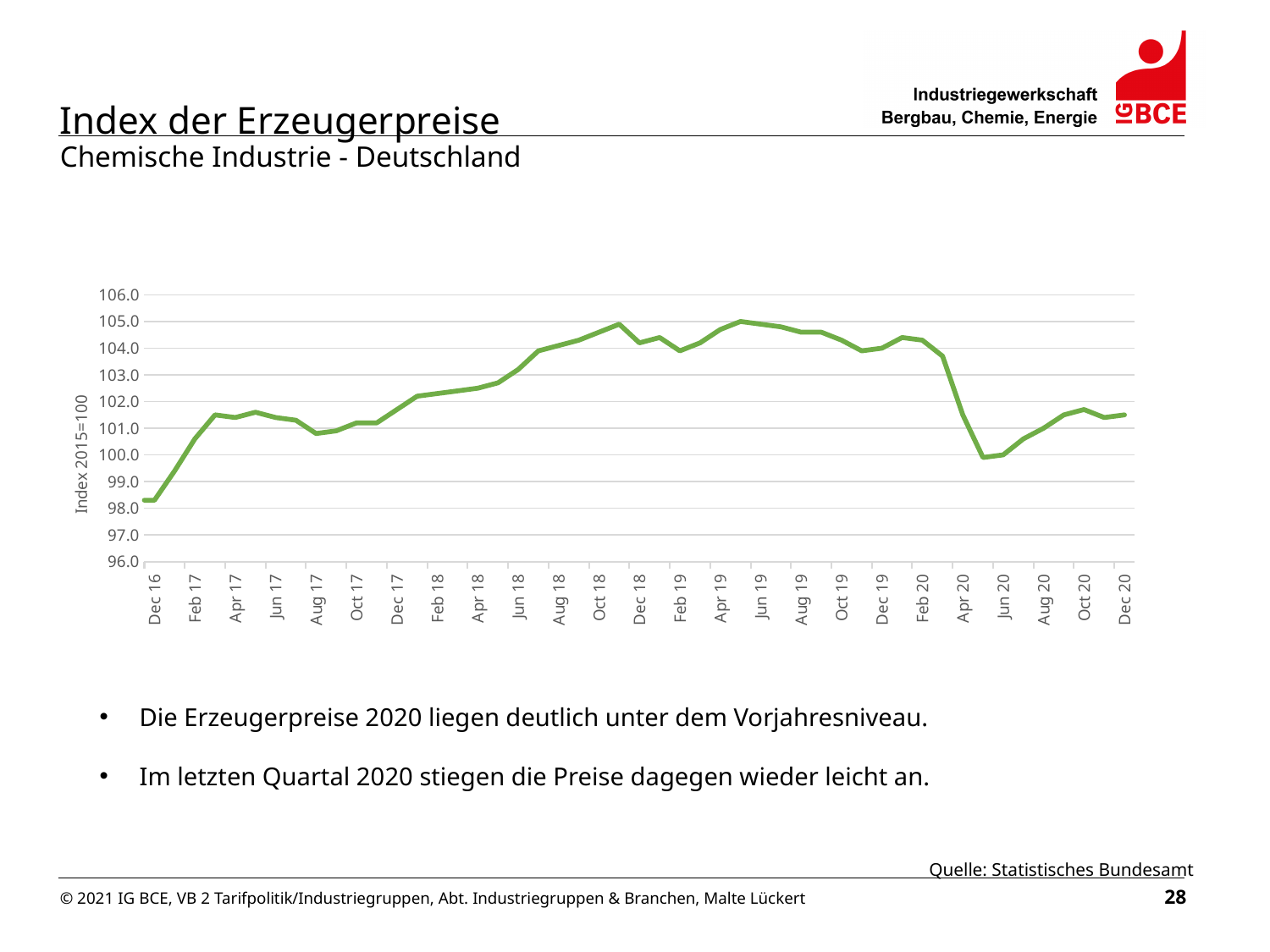
Which is larger, the value for Apr 19 or the value for Apr 20? Apr 19 Which month has the lowest index value on the chart? Dec 16 What kind of chart is shown on the slide? line chart Is the value for Dec 20 greater or less than 102.0? less What is the label of the vertical axis? Index 2015=100 Which is larger, the value for Dec 16 or the value for Dec 20? Dec 20 Is the value for Feb 17 greater or less than 101.0? less Do the values rise or fall between Feb 20 and Apr 20? fall Is the value for Apr 18 greater or less than 102.0? greater What is the subtitle under the chart title 'Index der Erzeugerpreise'? Chemische Industrie - Deutschland